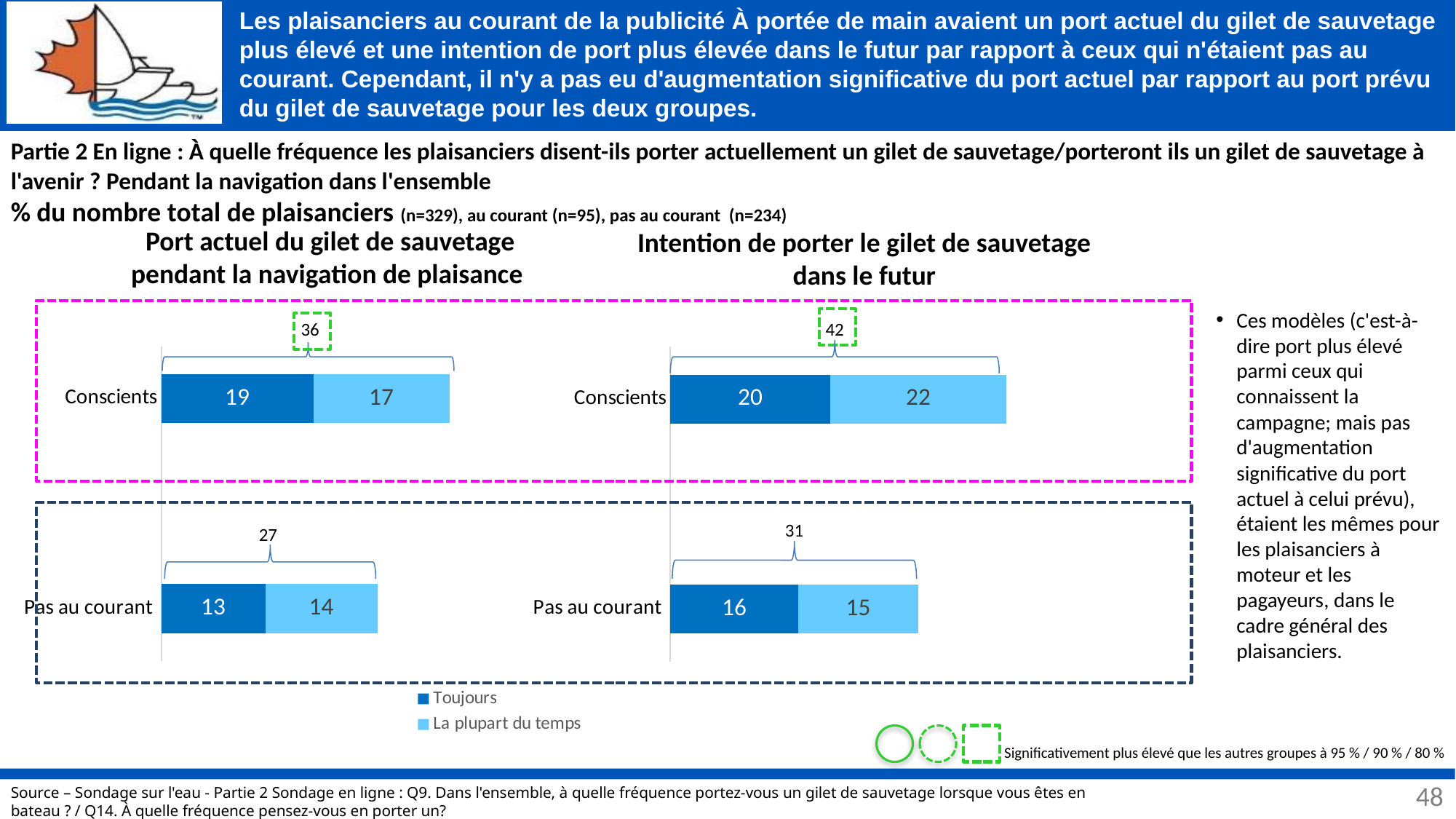
In the chart 'Port actuel du gilet de sauvetage pendant la navigation de plaisance', what is the total of the stacked bar for Conscients? 36 In the chart 'Port actuel du gilet de sauvetage pendant la navigation de plaisance', what is the 'La plupart du temps' value for Pas au courant? 14 In the chart 'Intention de porter le gilet de sauvetage dans le futur', what is the total of the stacked bar for Pas au courant? 31 In the chart 'Intention de porter le gilet de sauvetage dans le futur', what is the 'La plupart du temps' value for Conscients? 22 In the chart 'Intention de porter le gilet de sauvetage dans le futur', what is the 'Toujours' value for Pas au courant? 16 In the chart 'Port actuel du gilet de sauvetage pendant la navigation de plaisance', which category has the higher 'Toujours' value, Conscients or Pas au courant? Conscients How many categories are shown in the chart 'Port actuel du gilet de sauvetage pendant la navigation de plaisance'? 2 In the chart 'Port actuel du gilet de sauvetage pendant la navigation de plaisance', what is the 'Toujours' value for Conscients? 19 In the chart 'Intention de porter le gilet de sauvetage dans le futur', which category has the higher stacked-bar total? Conscients In the chart 'Intention de porter le gilet de sauvetage dans le futur', what is the difference between the 'Toujours' values for Conscients and Pas au courant? 4 What kind of chart is 'Intention de porter le gilet de sauvetage dans le futur'? Stacked bar chart How many series does the legend list for the charts on the slide? 2